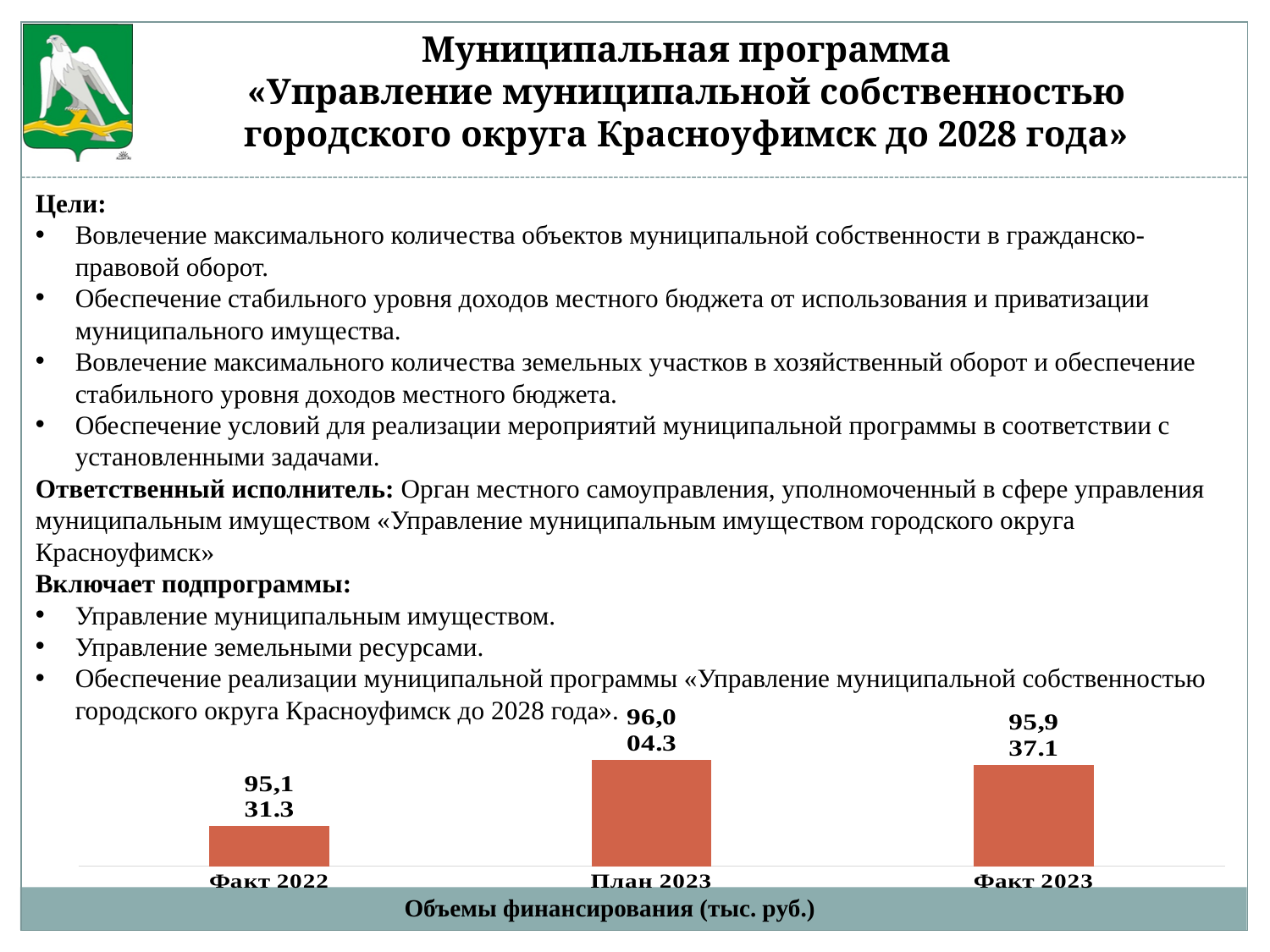
What is the difference between the values for Факт 2023 and Факт 2022? 805.8 Which category has the lowest value in the chart? Факт 2022 What is the value for Факт 2023 in the chart? 95,937.1 What is the title of the chart? Объемы финансирования (тыс. руб.) What is the value for Факт 2022 in the chart? 95,131.3 What is the difference between the values for План 2023 and Факт 2022? 873.0 What is the value for План 2023 in the chart? 96,004.3 Which category has the highest value in the chart? План 2023 What is the difference between the values for План 2023 and Факт 2023? 67.2 What kind of chart is shown on the slide? Bar chart Which is larger, the value for Факт 2022 or the value for Факт 2023? Факт 2023 How many categories are shown in the chart? 3